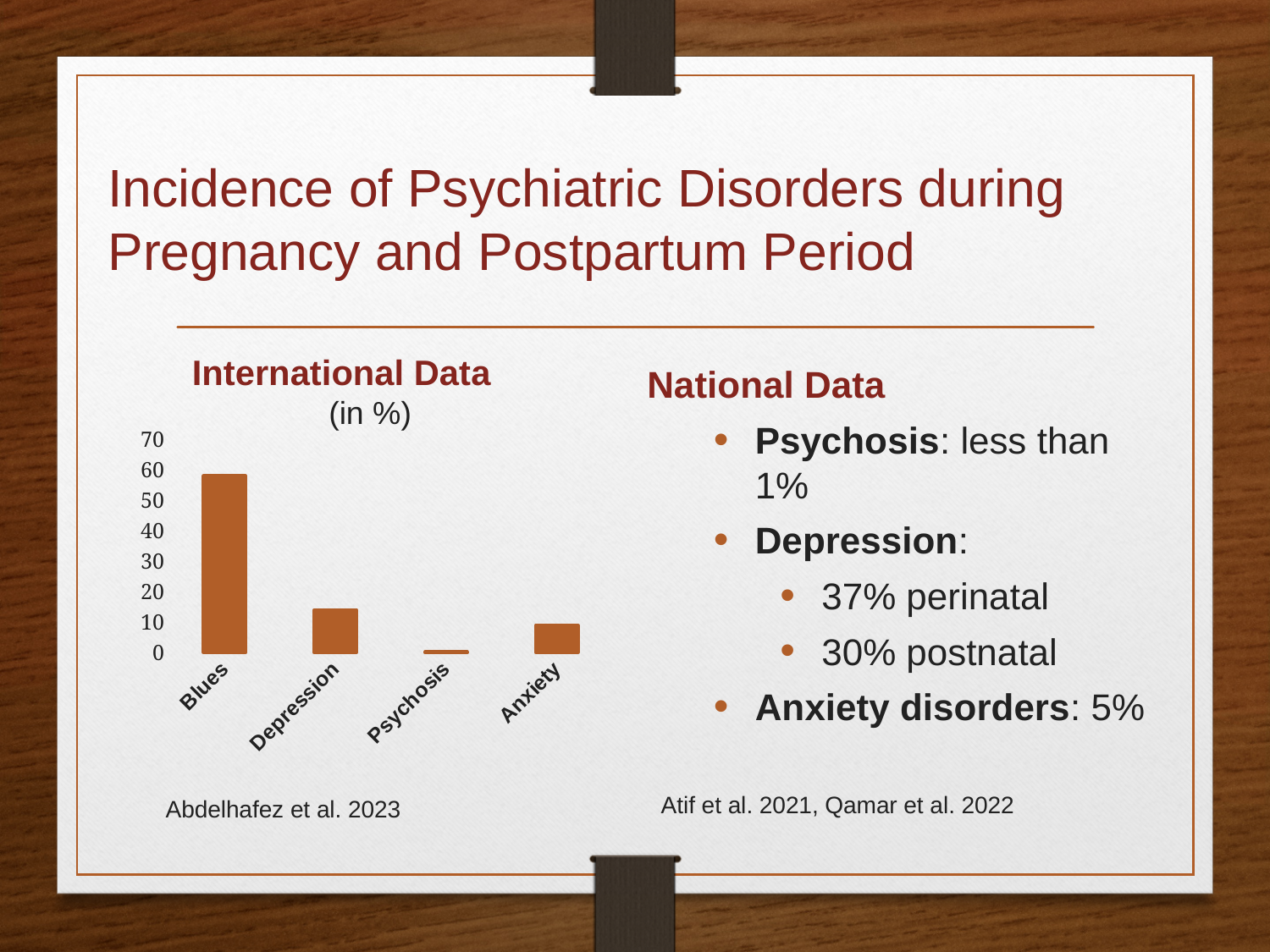
Is the value for Blues greater or less than 50? greater Which category has the highest value in the chart? Blues Is the value for Psychosis greater or less than 10? less Which is larger, the value for Blues or the value for Depression? Blues Which category has the lowest value in the chart? Psychosis How many categories are shown on the x axis of the chart? 4 Is the value for Anxiety greater or less than 20? less Which is larger, the value for Anxiety or the value for Psychosis? Anxiety What kind of chart is shown on the slide? bar chart What is the highest value shown on the chart's vertical axis? 70 What is the title of the chart? International Data (in %)